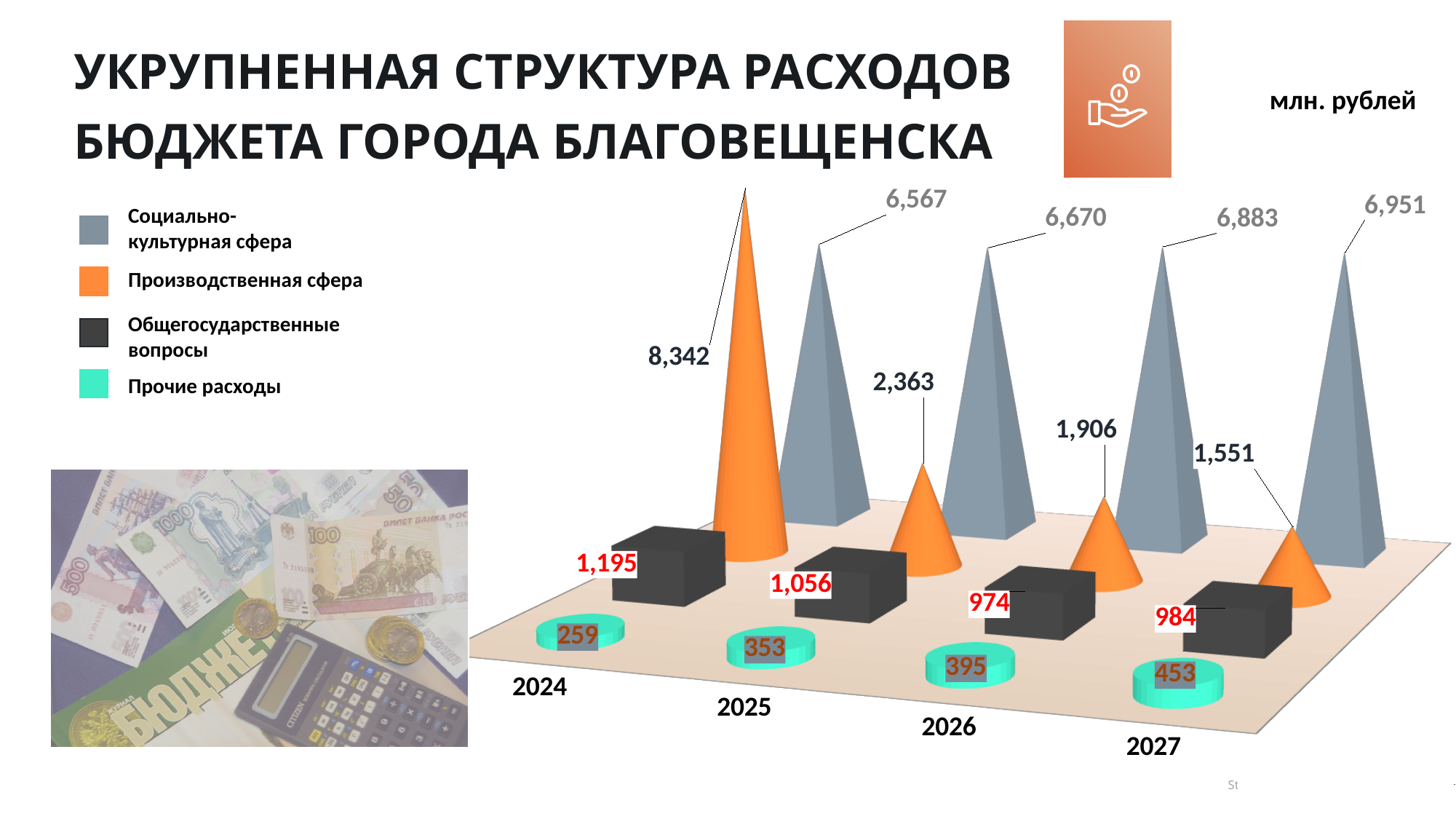
In which year is the value for Производственная сфера highest? 2024 What is the value for Прочие расходы in 2027? 453 What unit of measurement is stated for the chart values? млн. рублей How many series does the legend list? 4 What is the value for Социально-культурная сфера in 2024? 6,567 In which year is the value for Прочие расходы lowest? 2024 What is the value for Производственная сфера in 2025? 2,363 What is the difference between the Социально-культурная сфера values for 2027 and 2024? 384 Which is larger in 2024: Производственная сфера or Социально-культурная сфера? Производственная сфера How many years are shown on the x axis of the chart? 4 Do the values for Социально-культурная сфера rise or fall from 2024 to 2027? rise What is the value for Общегосударственные вопросы in 2026? 974